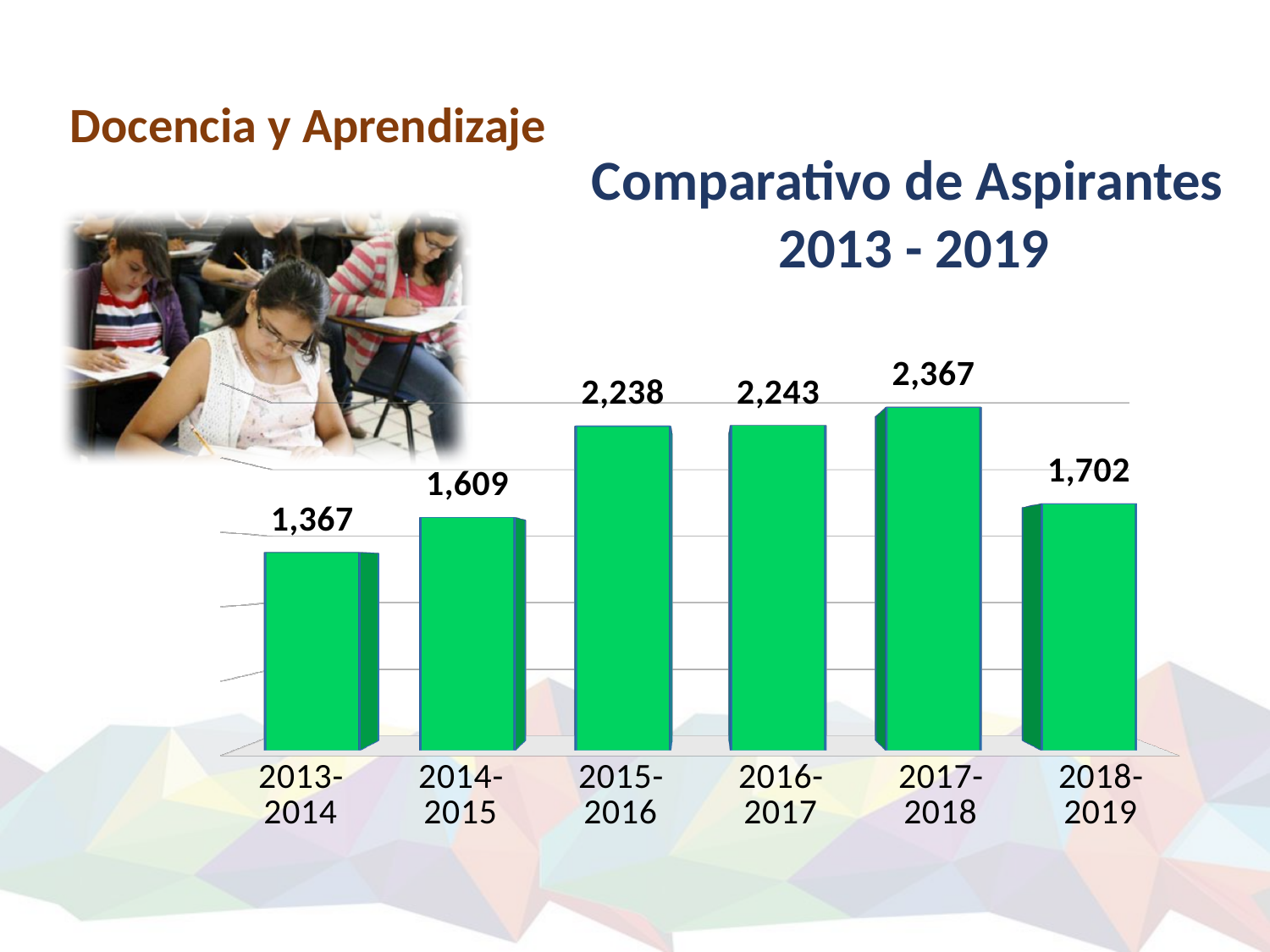
What is the difference between the values for 2018-2019 and 2014-2015? 93 What is the value for 2017-2018? 2,367 What is the title of the chart? Comparativo de Aspirantes 2013 - 2019 How many periods are shown on the x axis? 6 What is the value for 2013-2014? 1,367 Which period has the highest value? 2017-2018 Do the values rise or fall from 2013-2014 to 2017-2018? rise Which is larger, the value for 2015-2016 or the value for 2018-2019? 2015-2016 What is the value for 2018-2019? 1,702 What kind of chart is shown? bar chart Which period has the lowest value? 2013-2014 What is the difference between the values for 2017-2018 and 2013-2014? 1,000